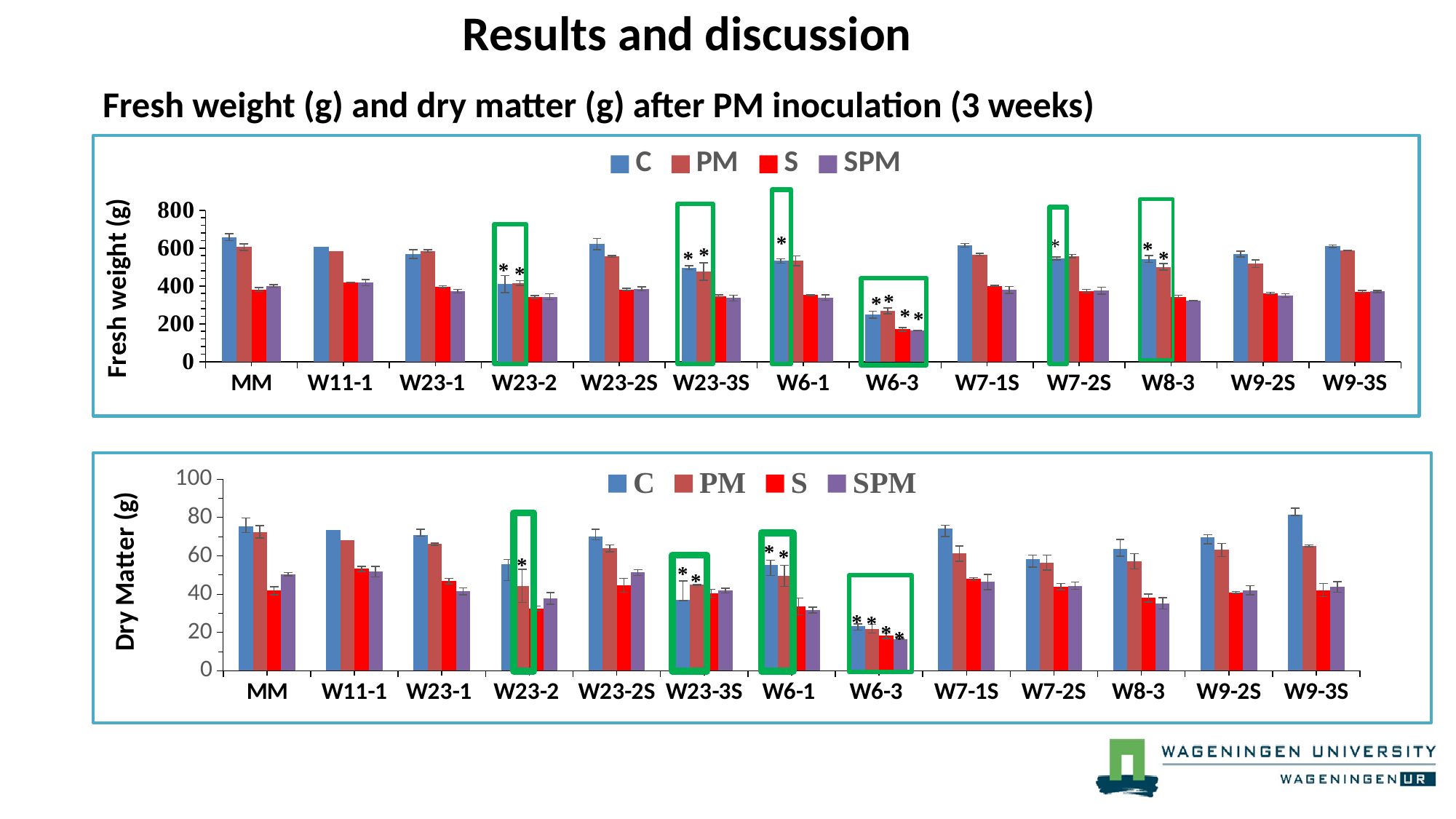
In the bottom chart (Dry Matter), which category has the lowest value for the C series? W6-3 In the bottom chart (Dry Matter), which is larger at W23-2: the C value or the PM value? C In the bottom chart (Dry Matter), is the value for S at W23-2 greater or less than 40? less How many categories are shown on the x axis of the bottom chart (Dry Matter)? 13 What kind of chart is the top chart (Fresh weight)? bar chart In the top chart (Fresh weight), which is larger at MM: the C value or the S value? C In the top chart (Fresh weight), which category has the lowest value for the C series? W6-3 How many series does the legend of the top chart (Fresh weight) list? 4 In the legend of the bottom chart (Dry Matter), which series is shown in red? S In the top chart (Fresh weight), is the value for S at W6-3 greater or less than 200? less In the top chart (Fresh weight), is the value for C at MM greater or less than 600? greater